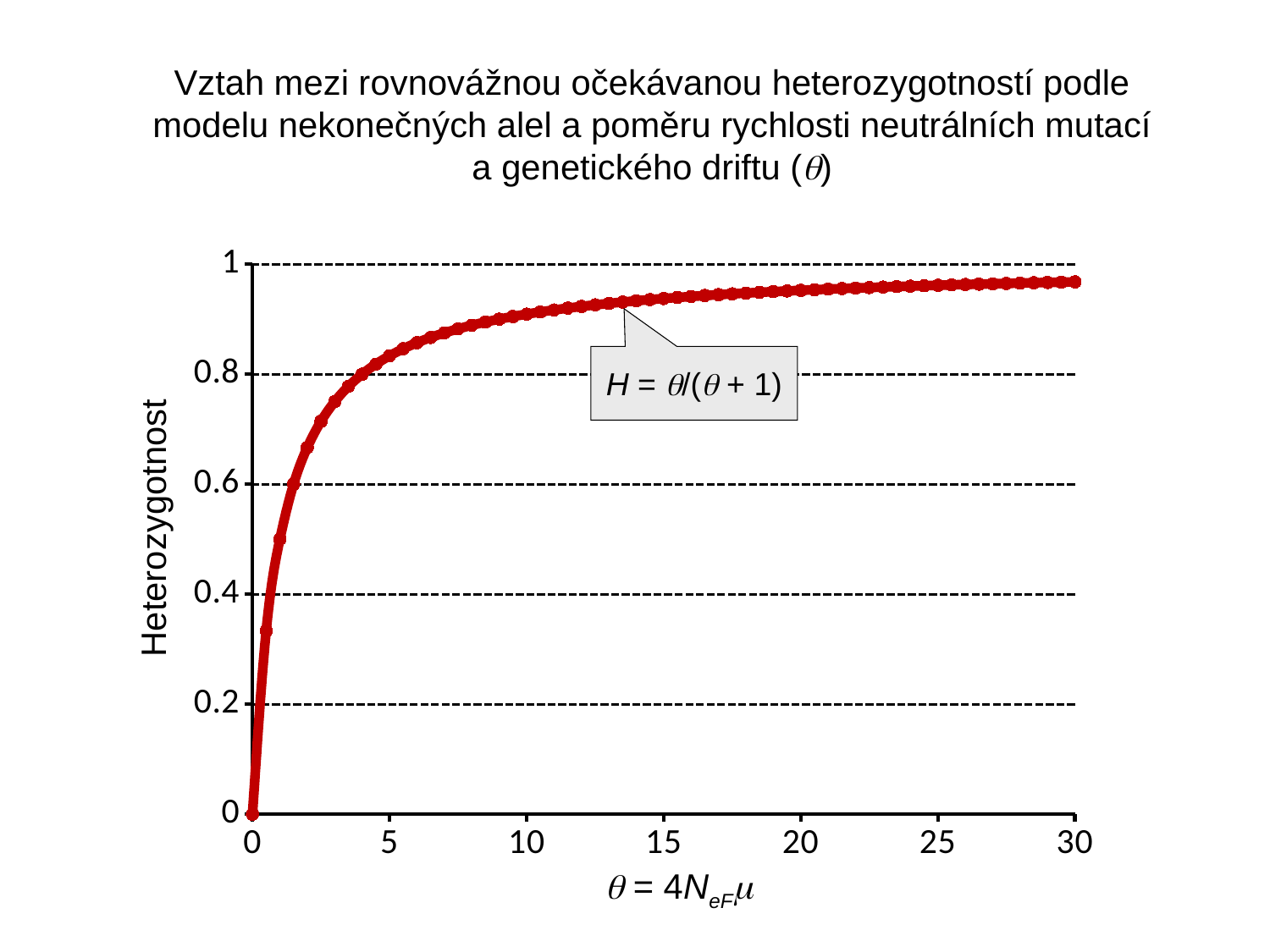
What kind of chart is shown on the slide? line chart Is the heterozygosity value at θ = 30 greater or less than 1? less What is the heterozygosity value at θ = 0? 0 What formula is shown in the callout box on the chart? H = θ/(θ + 1) Is the heterozygosity value at θ = 1 greater or less than 0.6? less Does the heterozygosity value rise or fall as θ increases along the x axis? rise What is the highest value shown on the x axis? 30 Which has the larger heterozygosity value, θ = 5 or θ = 20? θ = 20 Is the heterozygosity value at θ = 10 greater or less than 0.8? greater How many data series are plotted on the chart? 1 What is the label of the y axis? Heterozygotnost